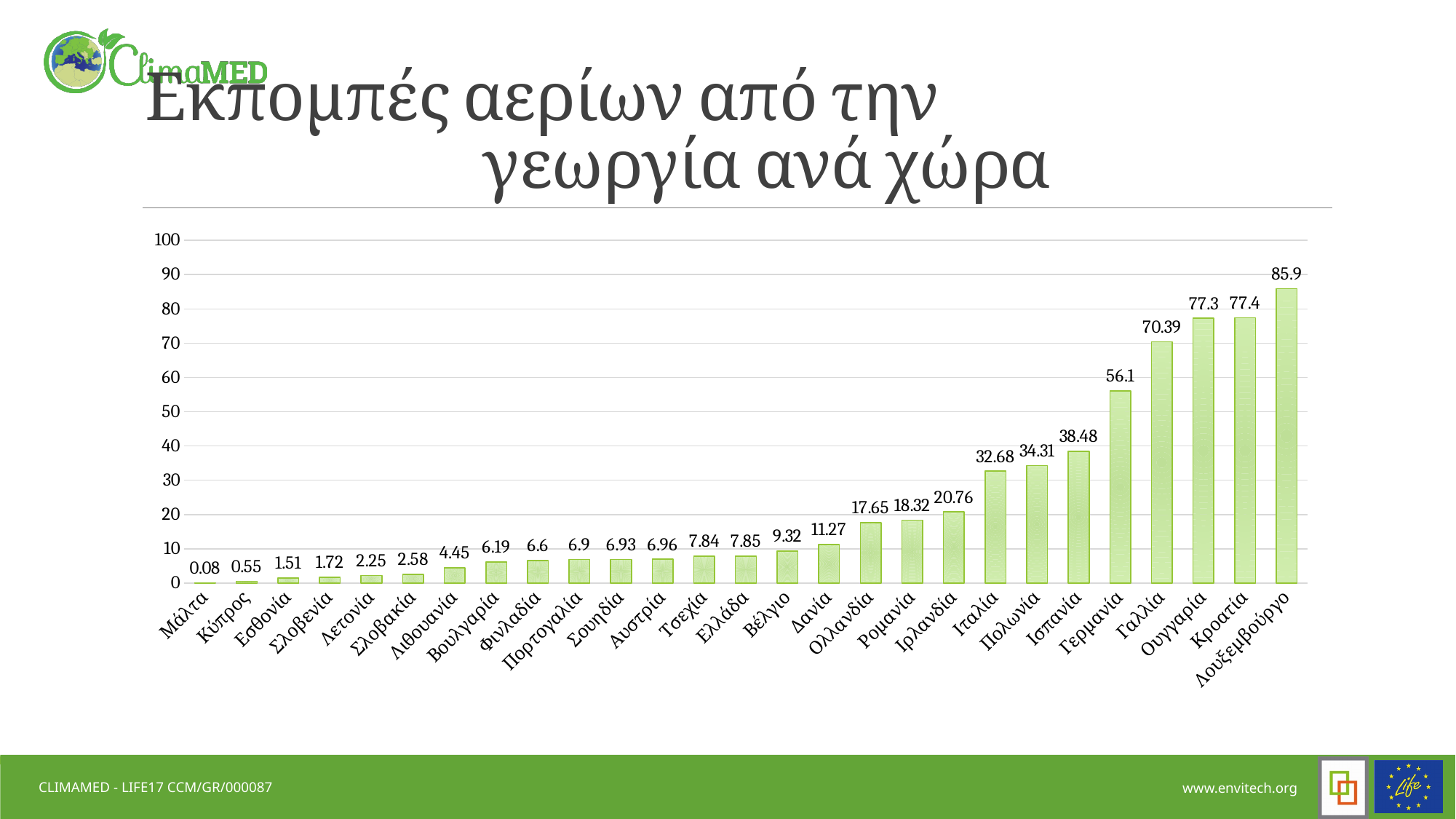
What kind of chart is shown on the slide? bar chart Which is larger, the value for Ιταλία or the value for Δανία? Ιταλία What is the value for Γερμανία? 56.1 How many countries are shown on the chart? 27 Which country has the lowest value? Μάλτα Which country has the highest value? Λουξεμβούργο Is the value for Γαλλία greater or less than 60? greater What is the value for Ιρλανδία? 20.76 What is the value for Ελλάδα? 7.85 What is the difference between the values for Ισπανία and Πολωνία? 4.17 Do the values rise or fall from left to right along the x axis? rise What is the difference between the values for Λουξεμβούργο and Γαλλία? 15.51